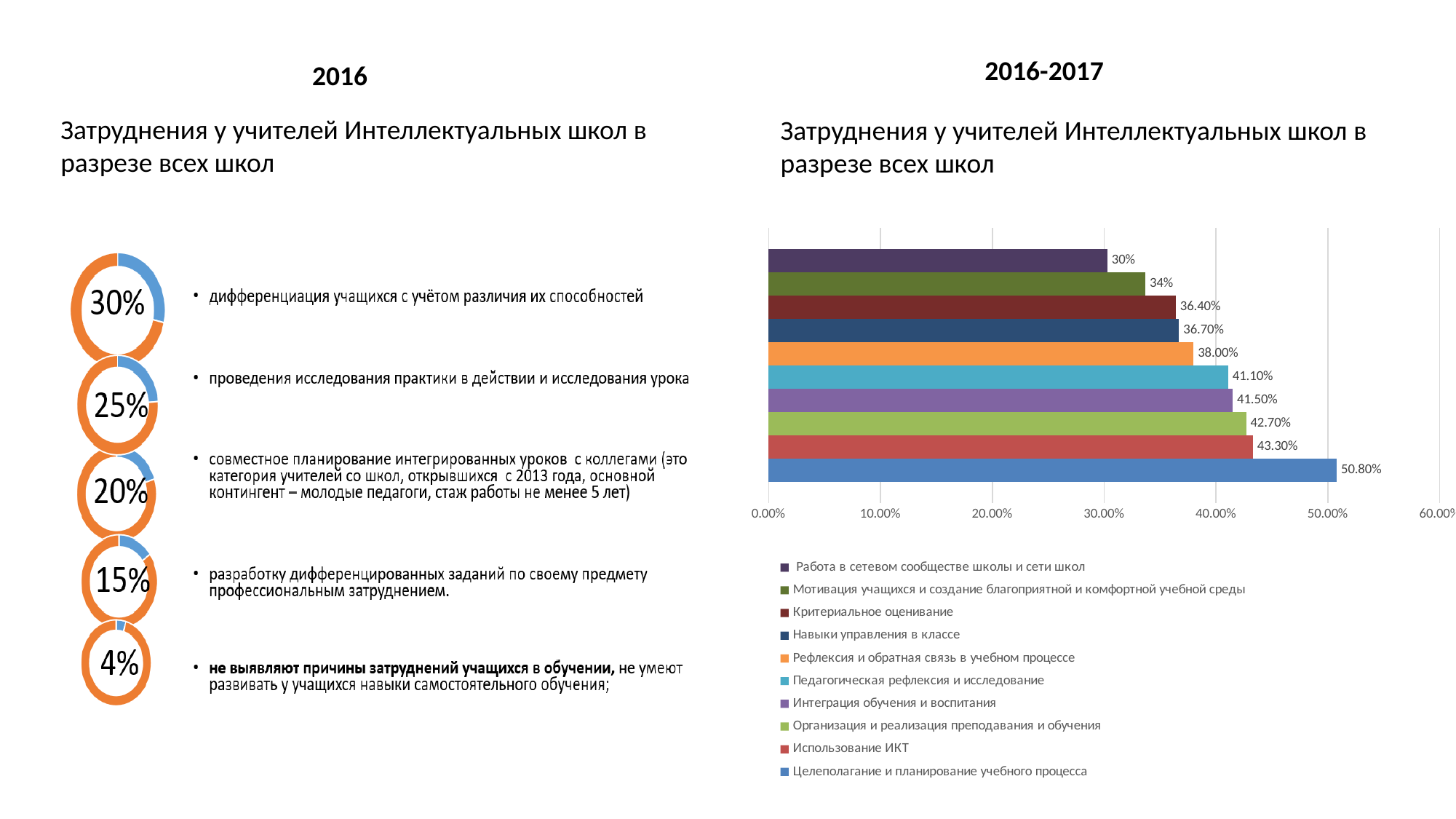
On the 2016-2017 bar chart, what is the value for Использование ИКТ? 43.30% On the 2016-2017 bar chart, which category has the lowest value? Работа в сетевом сообществе школы и сети школ How many bars are plotted on the 2016-2017 bar chart? 10 On the 2016-2017 bar chart, is the value for Организация и реализация преподавания и обучения greater or less than 40.00%? greater On the 2016-2017 bar chart, which category has the highest value? Целеполагание и планирование учебного процесса On the 2016-2017 bar chart, what is the value for Мотивация учащихся и создание благоприятной и комфортной учебной среды? 34% On the 2016-2017 bar chart, what is the value for Критериальное оценивание? 36.40% On the 2016-2017 bar chart, which is larger: the value for Педагогическая рефлексия и исследование or the value for Рефлексия и обратная связь в учебном процессе? Педагогическая рефлексия и исследование How many entries does the legend of the 2016-2017 chart list? 10 On the 2016-2017 bar chart, what is the value for Целеполагание и планирование учебного процесса? 50.80% What kind of chart is shown under the 2016-2017 heading? Bar chart On the 2016-2017 bar chart, what is the difference between the values for Целеполагание и планирование учебного процесса and Работа в сетевом сообществе школы и сети школ? 20.80%